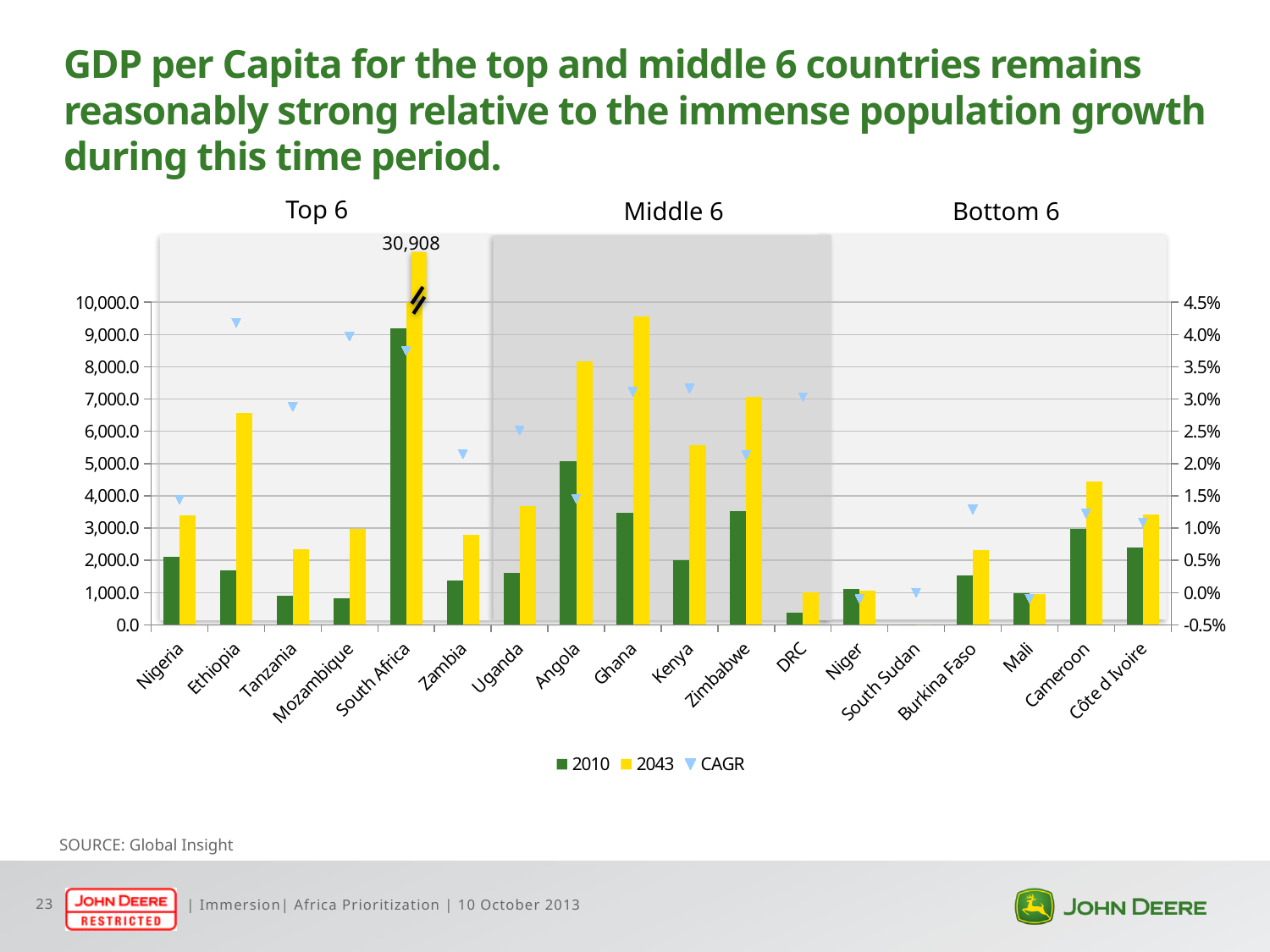
Is the CAGR for Ethiopia greater or less than 3.5%? greater Which has the larger 2043 value, Ethiopia or Tanzania? Ethiopia Is the 2010 value for Angola greater or less than 4,000.0? greater How many series does the legend list? 3 Which country has the highest 2043 GDP per capita? South Africa How many countries are shown on the x axis? 18 Is the 2043 value for Ghana greater or less than 9,000.0? greater What are the three group labels shown above the chart? Top 6, Middle 6, Bottom 6 Which has the larger 2010 value, Angola or Ghana? Angola What is the 2043 GDP per capita value labelled for South Africa? 30,908 What kind of chart is used to show the 2010 and 2043 GDP per capita values? Bar chart